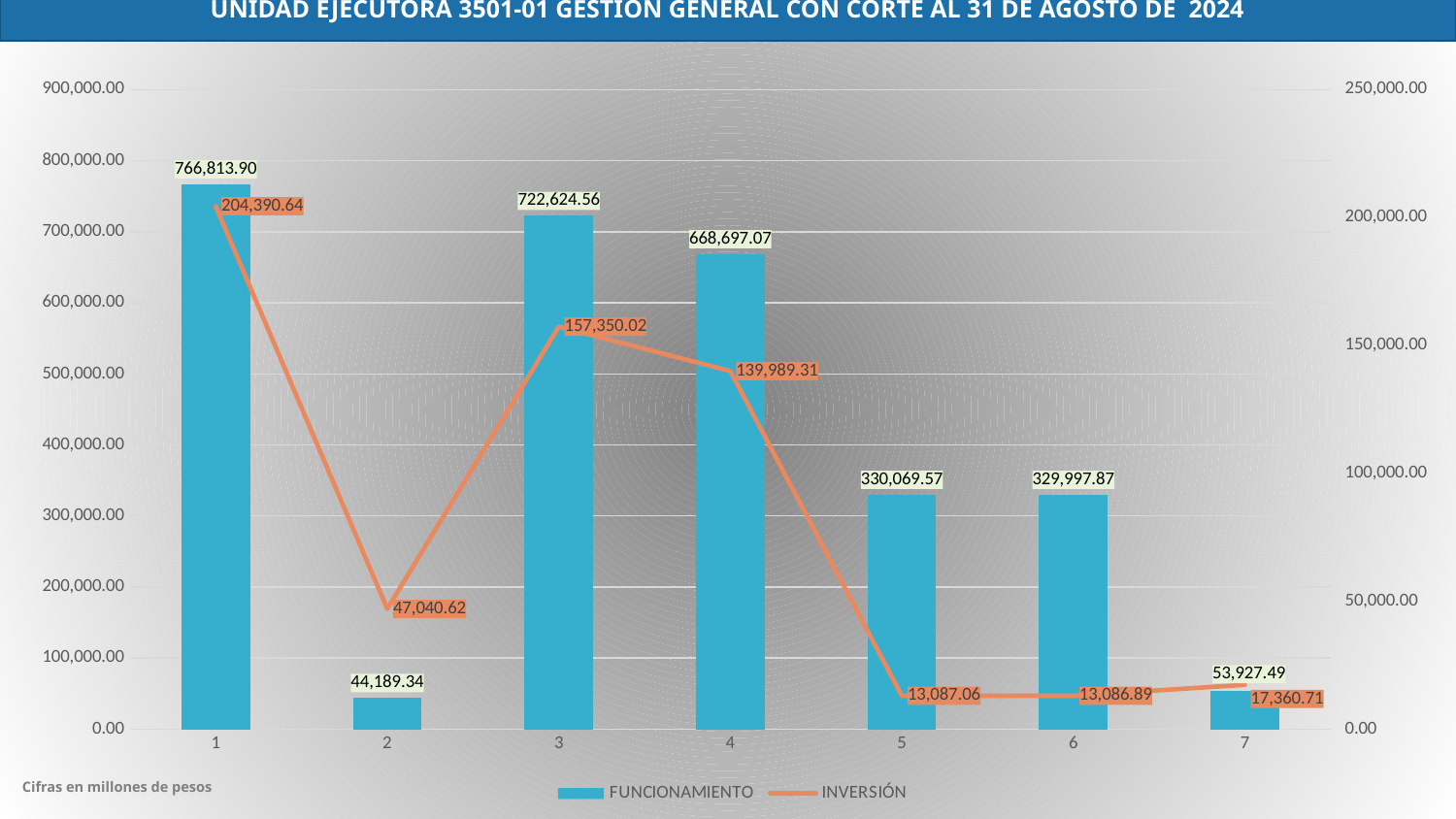
What is the difference between the FUNCIONAMIENTO values for category 3 and category 4? 53,927.49 What is the difference between the INVERSIÓN values for category 1 and category 2? 157,350.02 What is the INVERSIÓN value for category 3? 157,350.02 How many series does the legend list? 2 What is the FUNCIONAMIENTO value for category 1? 766,813.90 Which category has the highest INVERSIÓN value? 1 What is the FUNCIONAMIENTO value for category 7? 53,927.49 Which category has the highest FUNCIONAMIENTO value? 1 Which category has the lowest FUNCIONAMIENTO value? 2 Which is larger, the FUNCIONAMIENTO value for category 3 or for category 4? Category 3 What is the INVERSIÓN value for category 5? 13,087.06 How many categories are shown on the x axis? 7